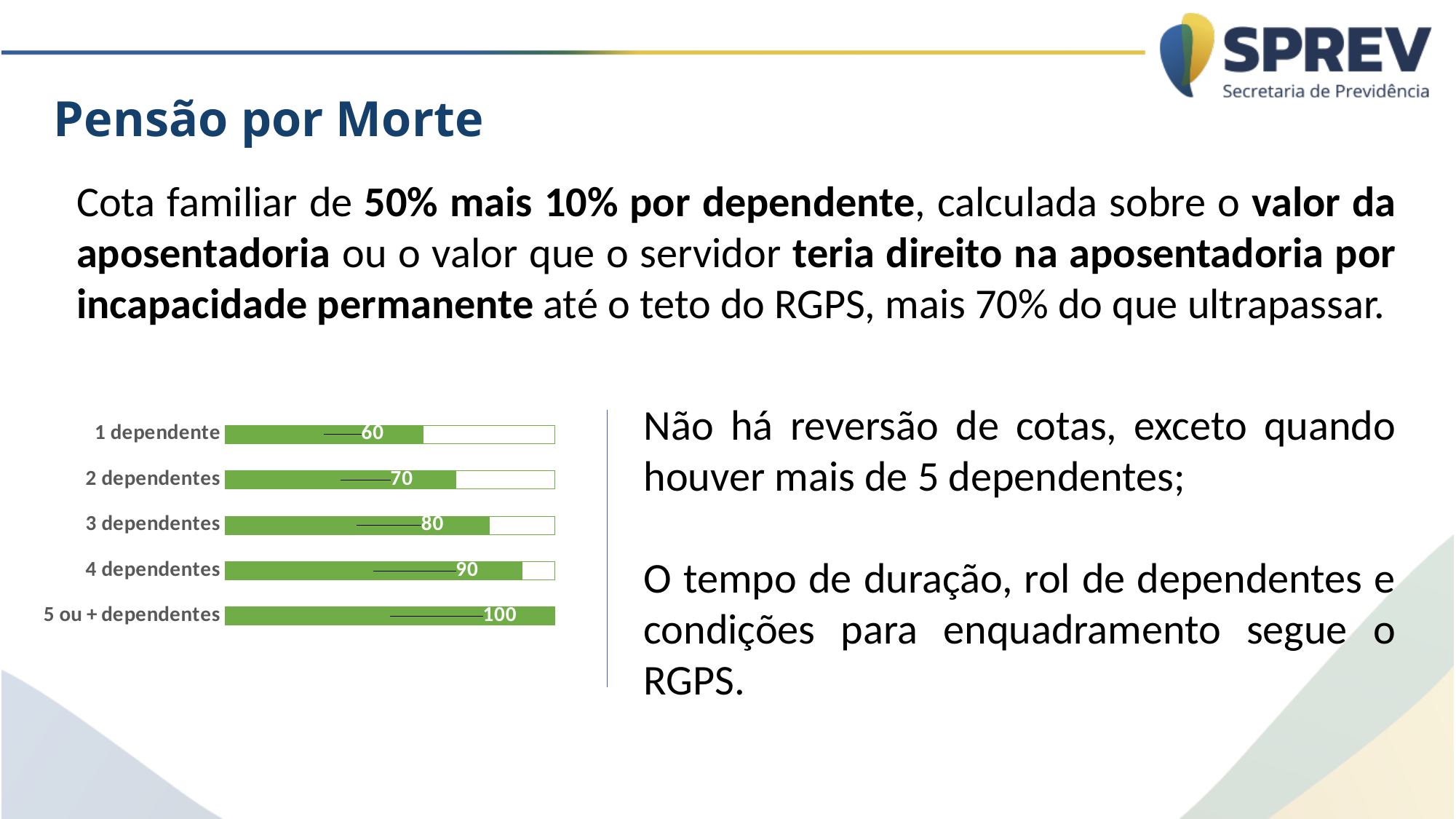
What colour are the bars in the chart? Green What is the value for 5 ou + dependentes? 100 What kind of chart is shown on the slide? Bar chart What is the difference between the values for 5 ou + dependentes and 1 dependente? 40 How many categories are shown in the chart? 5 What is the value for 1 dependente? 60 What is the value for 3 dependentes? 80 Which category has the lowest value? 1 dependente Do the values rise or fall as the number of dependentes increases? Rise What is the difference between the values for 4 dependentes and 2 dependentes? 20 Which is larger, the value for 2 dependentes or the value for 3 dependentes? 3 dependentes Which category has the highest value? 5 ou + dependentes